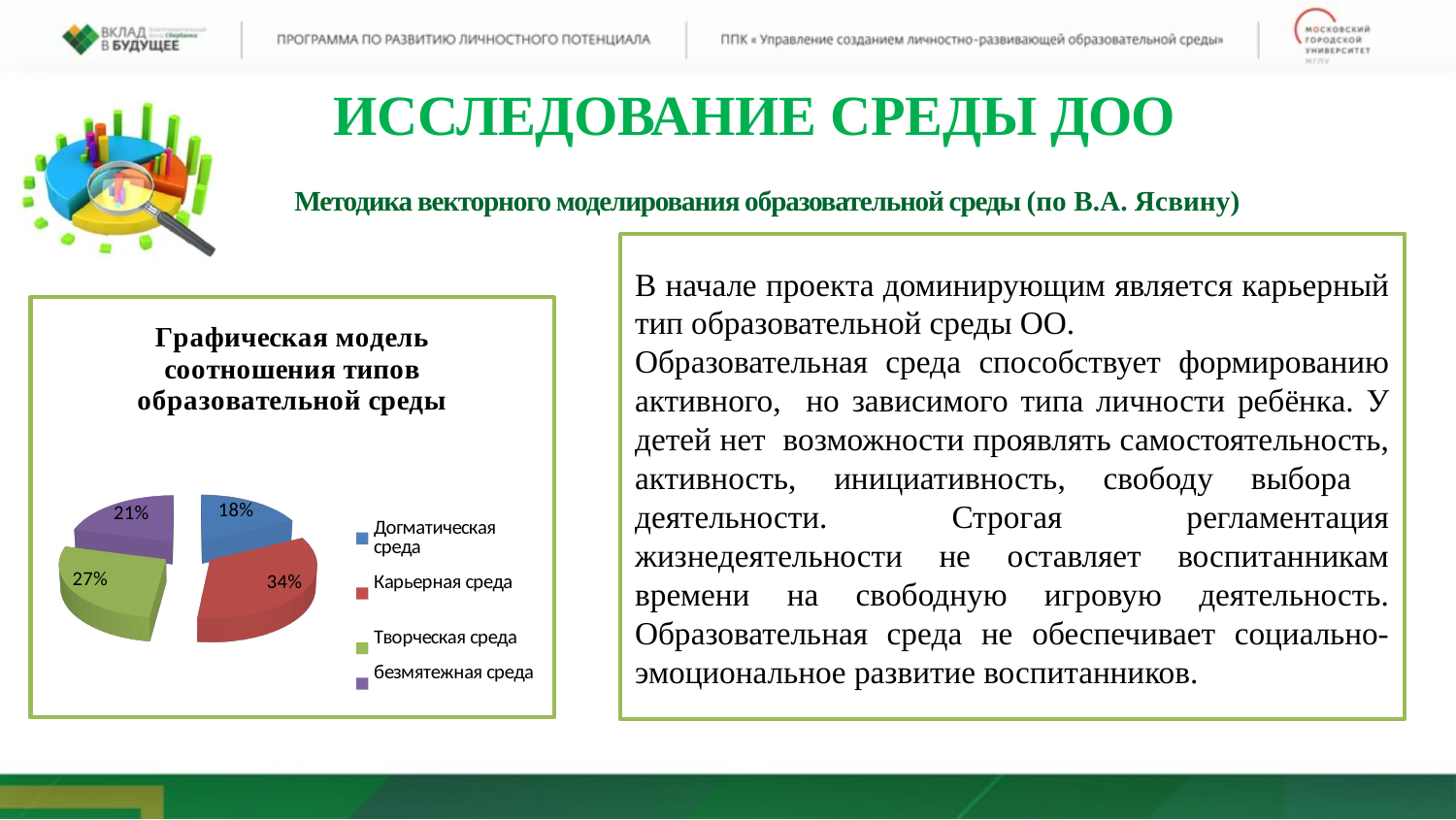
What is the share of безмятежная среда in the pie chart? 21% What is the title of the pie chart? Графическая модель соотношения типов образовательной среды What is the share of Карьерная среда in the pie chart? 34% Which has a larger share, Творческая среда or безмятежная среда? Творческая среда Which type of educational environment has the largest share in the pie chart? Карьерная среда What is the difference between the shares of Карьерная среда and Догматическая среда? 16% What is the share of Догматическая среда in the pie chart? 18% What type of chart is shown on the slide? pie chart What is the share of Творческая среда in the pie chart? 27% How many slices does the pie chart have? 4 How many entries does the legend of the pie chart list? 4 Which type of educational environment has the smallest share in the pie chart? Догматическая среда